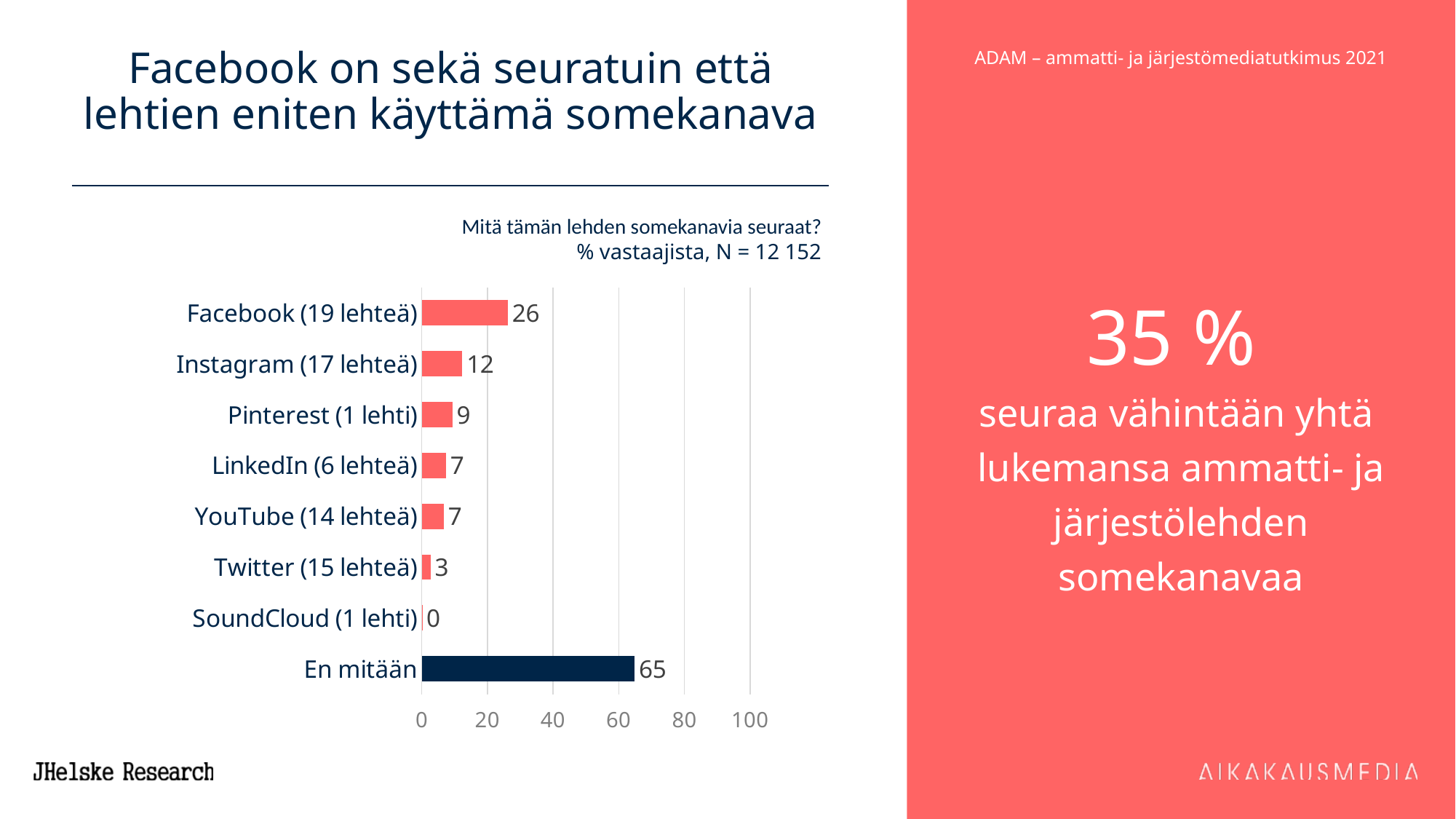
Which category has the lowest value? SoundCloud (1 lehti) What is the value for En mitään? 65 What is the difference between the values for Facebook (19 lehteä) and Instagram (17 lehteä)? 14 Which is larger, the value for Pinterest (1 lehti) or the value for LinkedIn (6 lehteä)? Pinterest (1 lehti) What is the N value stated in the chart subtitle? N = 12 152 What is the value for Facebook (19 lehteä)? 26 Which category has the highest value? En mitään What is the value for Twitter (15 lehteä)? 3 Is the value for En mitään greater or less than 60? greater What kind of chart is shown on the slide? bar chart How many categories are shown in the chart? 8 What is the value for Instagram (17 lehteä)? 12